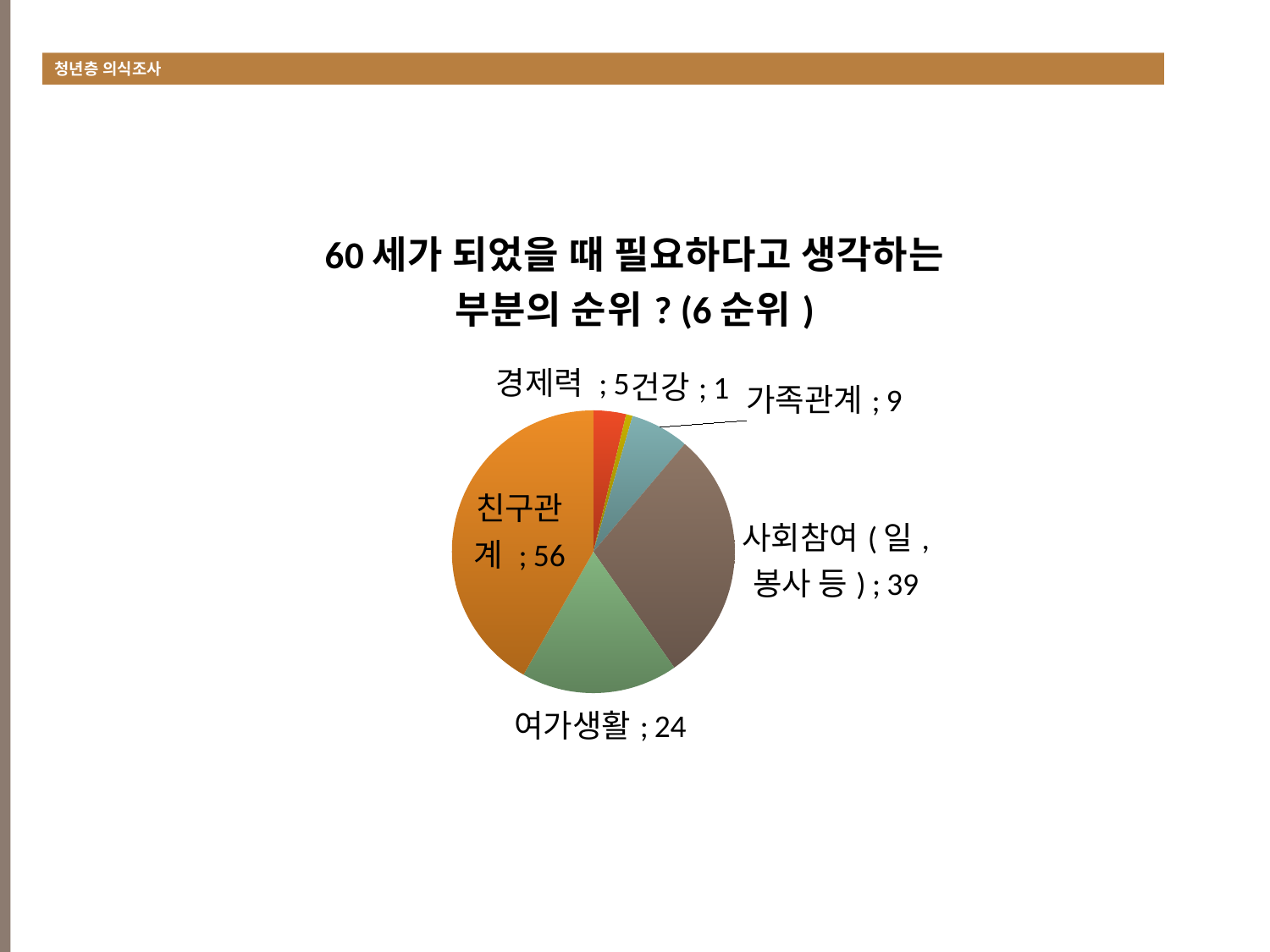
What is the title of the chart? 60 세가 되었을 때 필요하다고 생각하는 부분의 순위 ? (6 순위 ) What is the value for 여가생활 in the pie chart? 24 What kind of chart is shown on the slide? pie chart Which is larger, the value for 여가생활 or the value for 가족관계? 여가생활 What is the value for 사회참여 (일, 봉사 등) in the pie chart? 39 What is the value for 친구관계 in the pie chart? 56 What is the difference between the values for 친구관계 and 사회참여 (일, 봉사 등)? 17 Which category has the largest slice in the pie chart? 친구관계 Which category has the smallest slice in the pie chart? 건강 How many categories are shown in the pie chart? 6 What is the value for 가족관계 in the pie chart? 9 What is the value for 건강 in the pie chart? 1